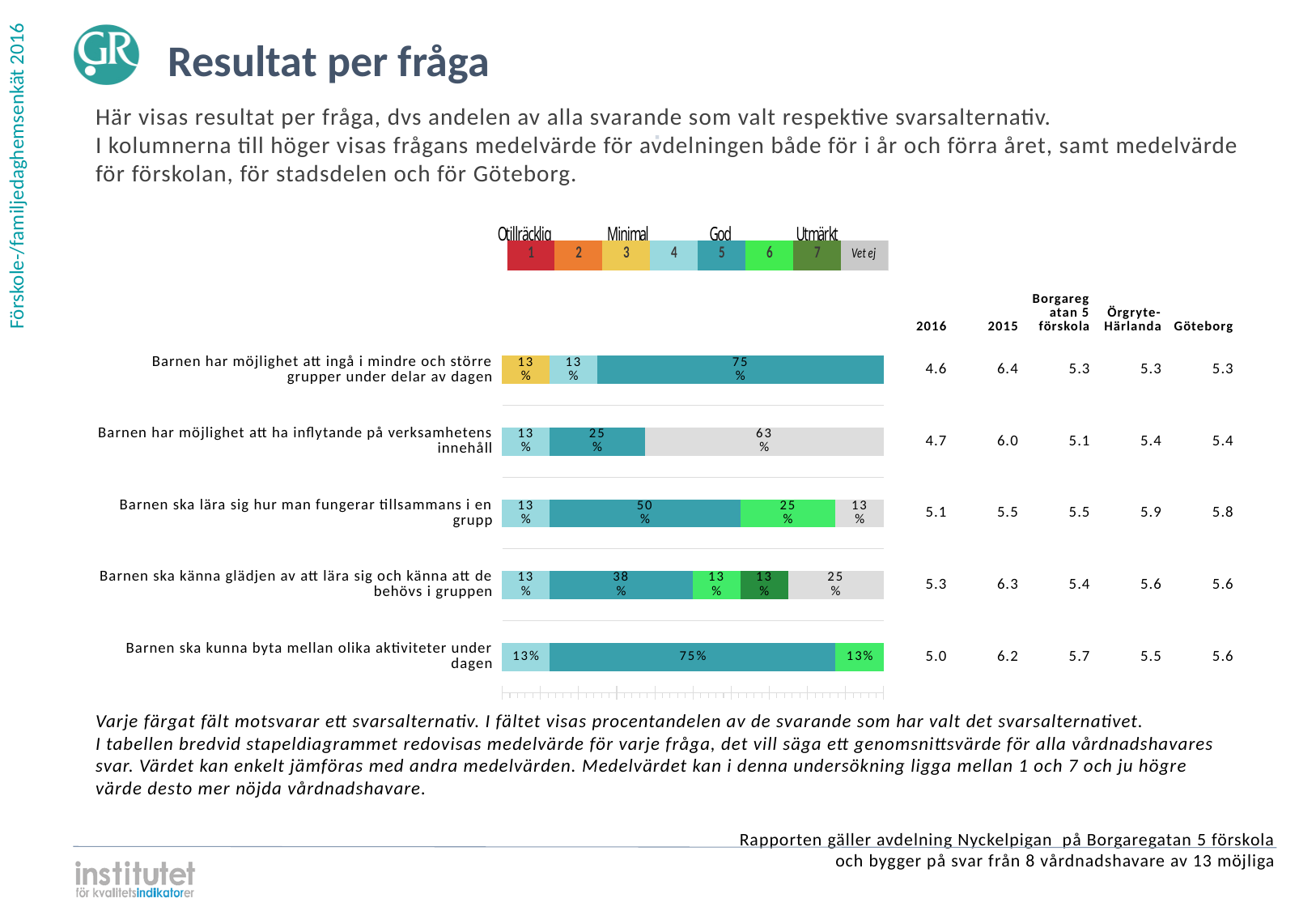
Which is larger for 'Barnen ska känna glädjen av att lära sig och känna att de behövs i gruppen': the share for answer 5 or the share for 'Vet ej'? Answer 5 (38%) What percentage of respondents chose answer 5 (God, teal) for 'Barnen har möjlighet att ingå i mindre och större grupper under delar av dagen'? 75% What is the 2016 mean value for 'Barnen har möjlighet att ingå i mindre och större grupper under delar av dagen'? 4.6 What is the difference between the share for answer 5 and the share for answer 6 in the bar for 'Barnen ska kunna byta mellan olika aktiviteter under dagen'? 62 percentage points What kind of chart is used to show the results per question on this slide? Stacked bar chart How many questions (bars) are shown in the chart? 5 What is the Göteborg mean value for 'Barnen ska lära sig hur man fungerar tillsammans i en grupp'? 5.8 Which answer alternative has the largest share for 'Barnen ska kunna byta mellan olika aktiviteter under dagen'? 5 (God), 75% What percentage of respondents chose answer 7 (dark green) for 'Barnen ska känna glädjen av att lära sig och känna att de behövs i gruppen'? 13% How many answer alternatives does the legend above the chart list? 8 What percentage of respondents chose answer 6 (bright green) for 'Barnen ska lära sig hur man fungerar tillsammans i en grupp'? 25% What percentage of respondents answered 'Vet ej' for 'Barnen har möjlighet att ha inflytande på verksamhetens innehåll'? 63%